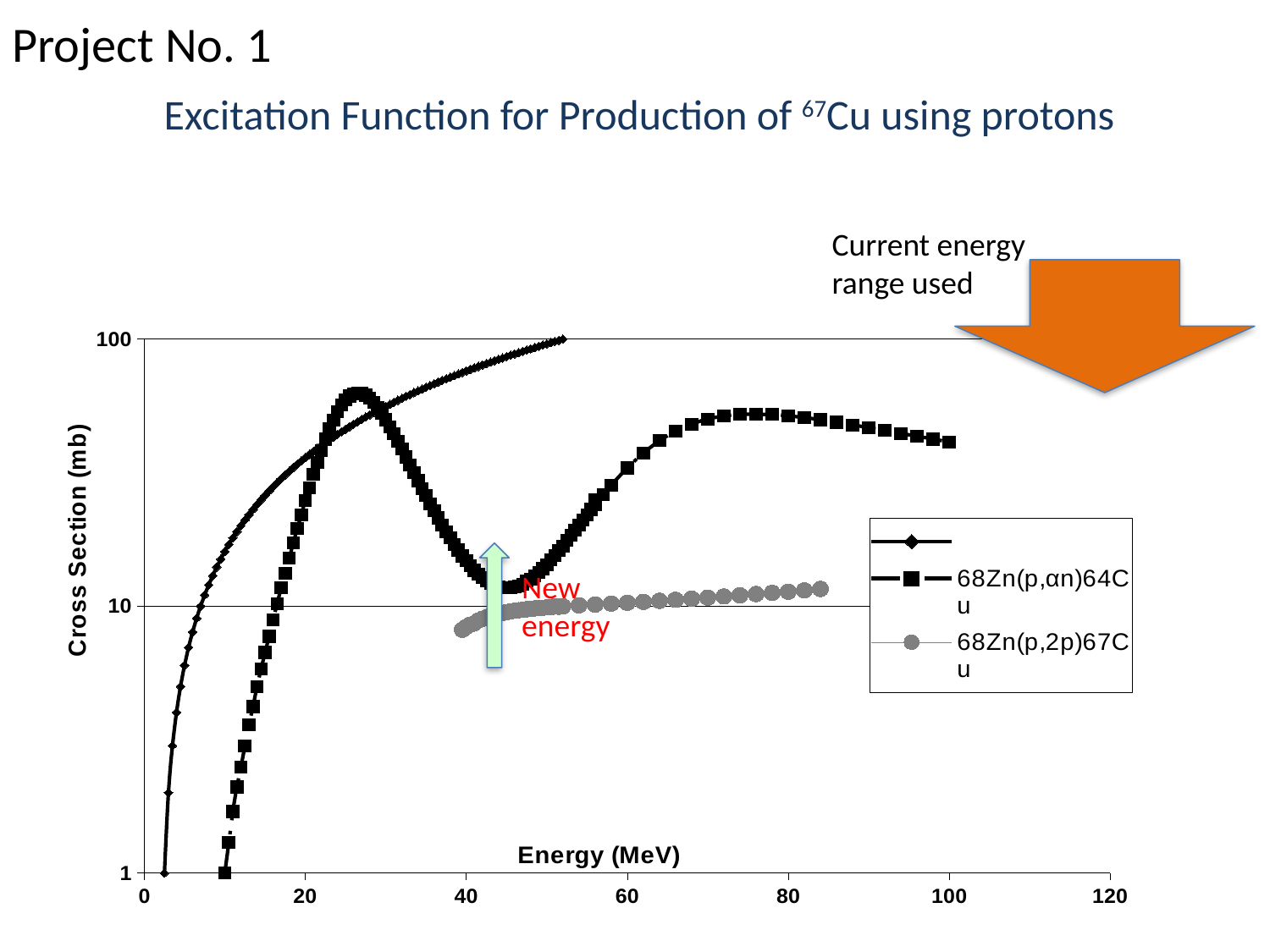
Which of the two labeled series, 68Zn(p,αn)64Cu or 68Zn(p,2p)67Cu, reaches the higher peak cross section? 68Zn(p,αn)64Cu How many series does the chart's legend list? 3 Does the cross section for 68Zn(p,2p)67Cu rise or fall as energy increases from 40 MeV to 80 MeV? rise Is the cross section for 68Zn(p,2p)67Cu at 40 MeV greater or less than 10? less What is the label of the y axis of the chart? Cross Section (mb) Does the cross section for 68Zn(p,αn)64Cu rise or fall as energy increases from 80 MeV to 100 MeV? fall What is the label of the x axis of the chart? Energy (MeV) At 60 MeV, which series has the larger cross section, 68Zn(p,αn)64Cu or 68Zn(p,2p)67Cu? 68Zn(p,αn)64Cu Is the cross section for 68Zn(p,αn)64Cu at 80 MeV greater or less than 10? greater What kind of chart is shown on the slide? Line chart Is the cross section for 68Zn(p,αn)64Cu at 100 MeV greater or less than 100? less